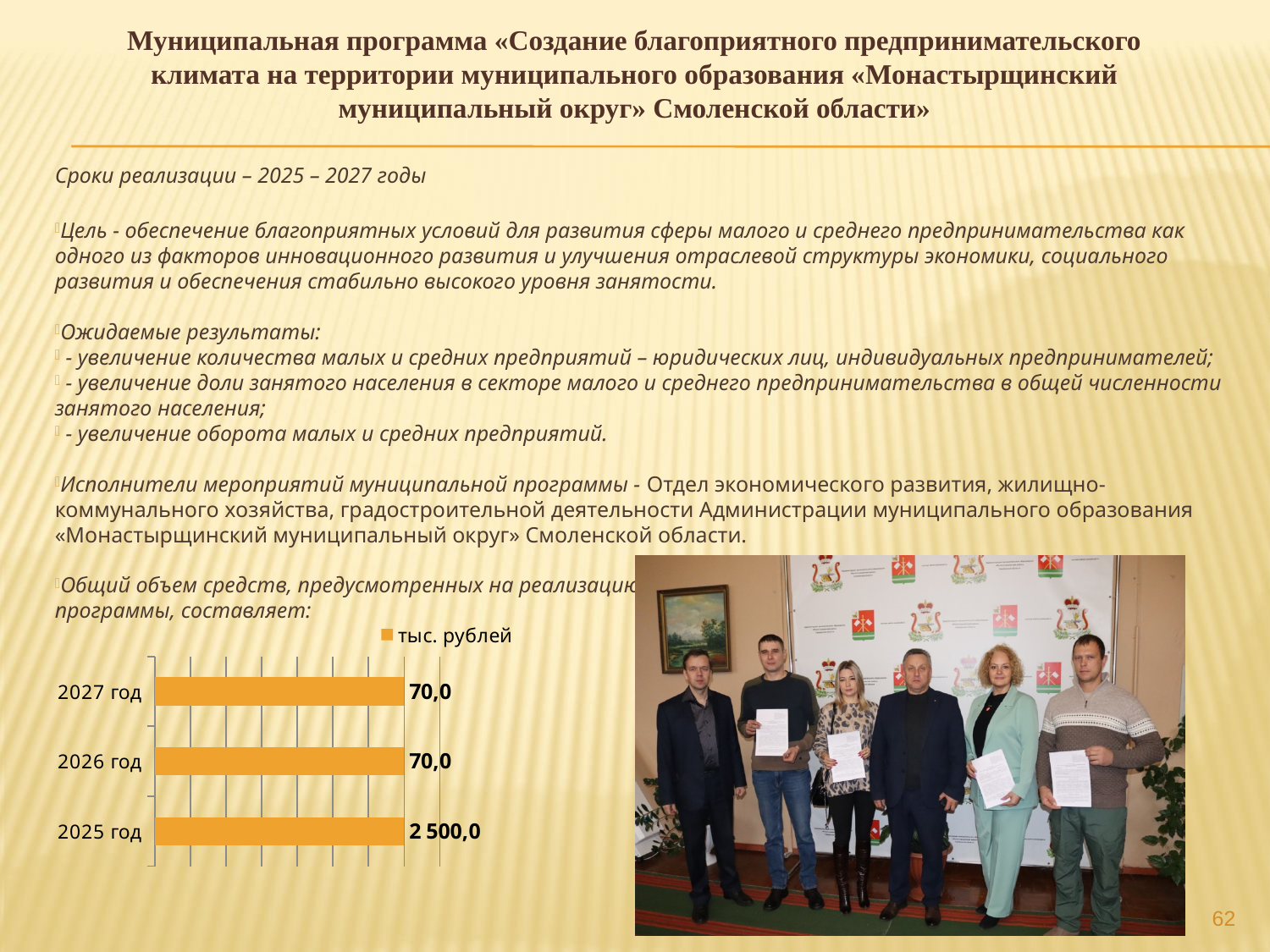
What is the value for 2025 год? 2 500,0 What is the value for 2026 год? 70,0 What is the legend entry of the chart? тыс. рублей How many categories are shown in the chart? 3 How many series does the legend list? 1 Are the values for 2026 год and 2027 год equal? Yes What is the value for 2027 год? 70,0 What kind of chart is shown on the slide? bar chart